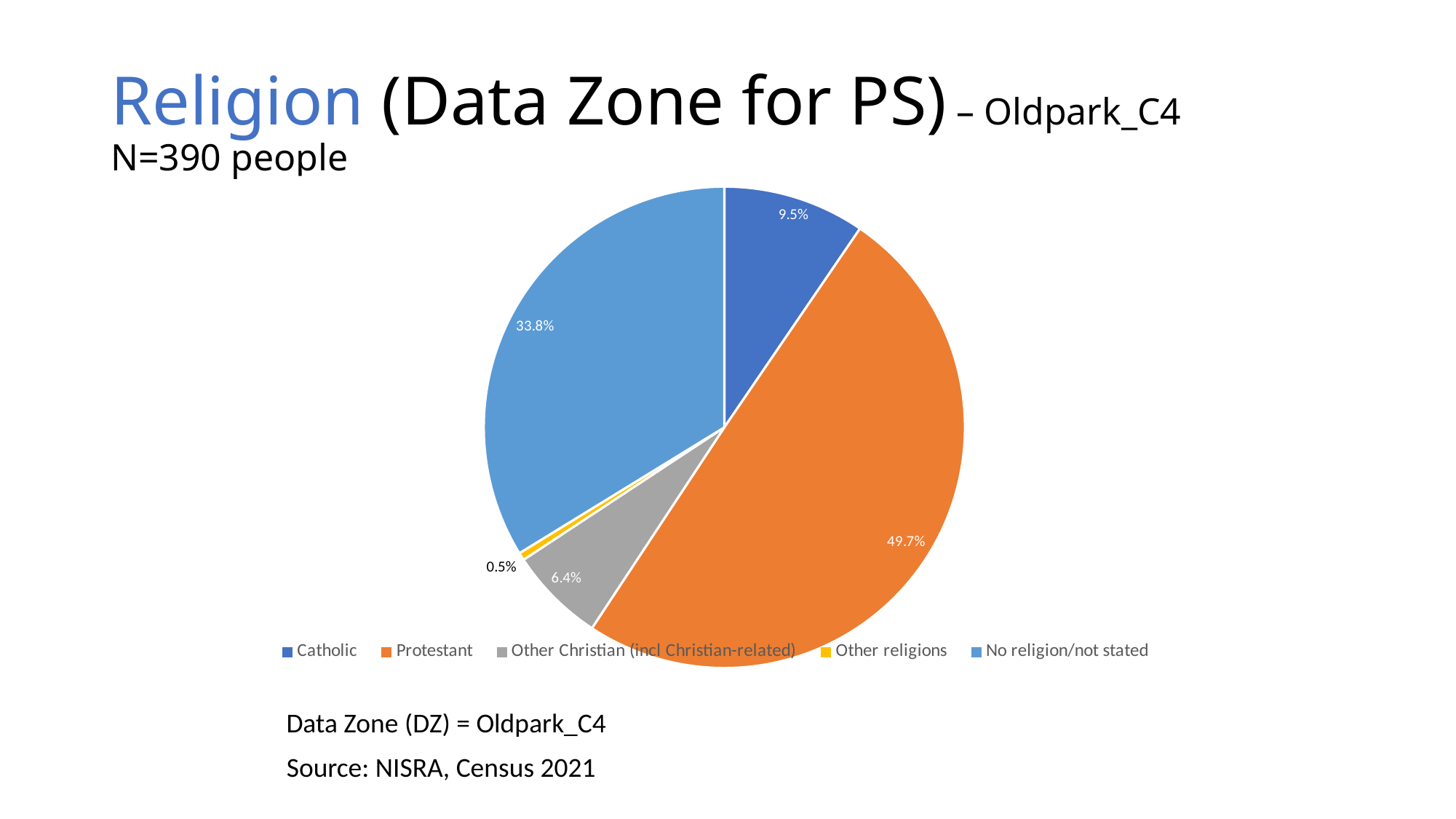
How many people does the slide say the data covers (N)? 390 What percentage of the pie is Other Christian (incl Christian-related)? 6.4% What percentage of the pie is Catholic? 9.5% What percentage of the pie is Other religions? 0.5% How many categories does the legend list? 5 What kind of chart is shown on the slide? Pie chart What is the difference in percentage points between Protestant and No religion/not stated? 15.9 Which category has the largest share of the pie? Protestant Which category has the smallest share of the pie? Other religions Which is larger, the Catholic share or the Other Christian (incl Christian-related) share? Catholic What percentage of the pie is Protestant? 49.7% What percentage of the pie is No religion/not stated? 33.8%